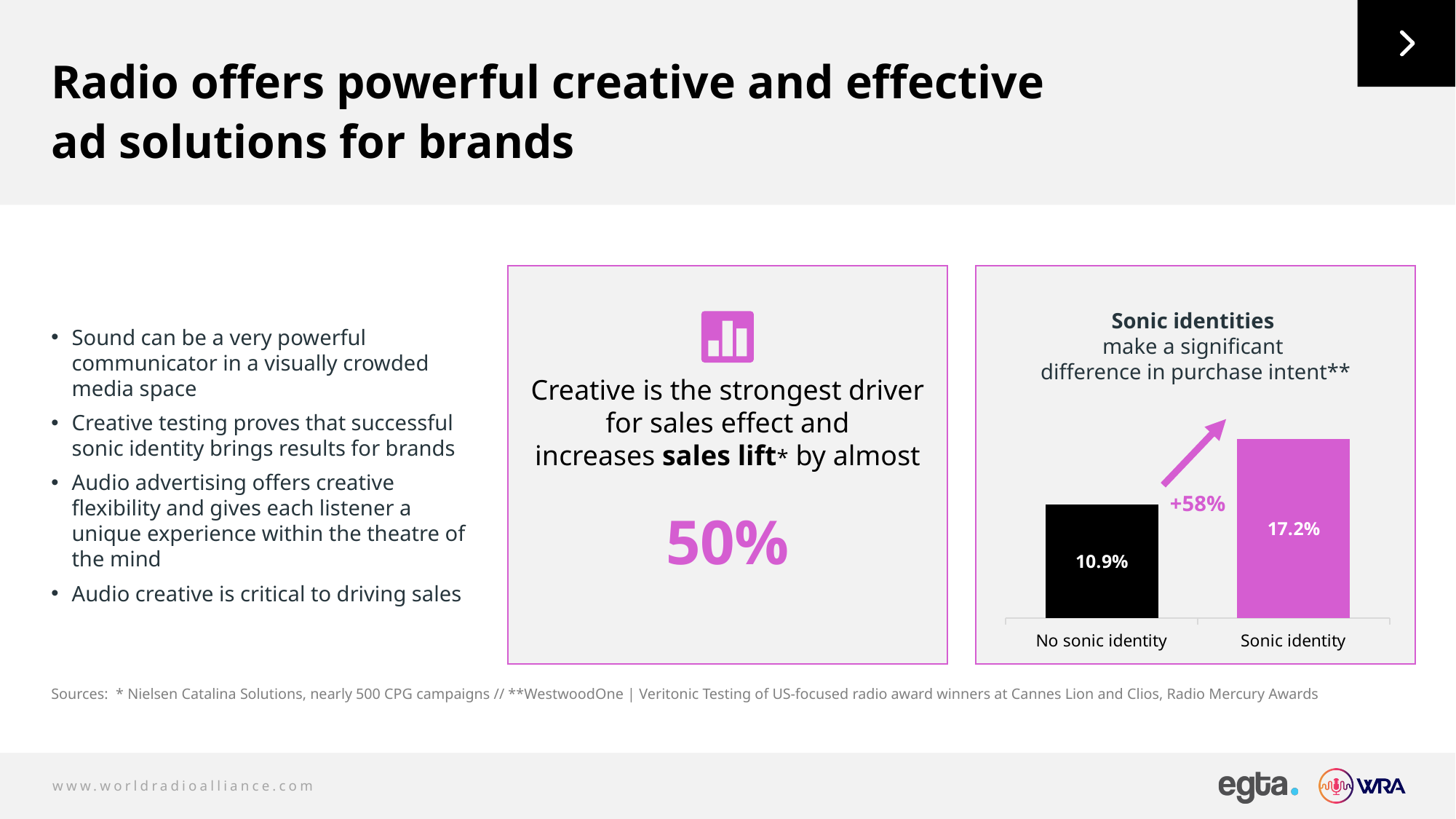
Which category has the higher value in the purchase intent chart? Sonic identity Is the value for Sonic identity larger or smaller than the value for No sonic identity? larger What kind of chart is used to show purchase intent by sonic identity? bar chart What colour is the Sonic identity bar in the purchase intent chart? pink/magenta How many categories are shown in the purchase intent chart? 2 What is the value for No sonic identity in the purchase intent chart? 10.9% What is the value for Sonic identity in the purchase intent chart? 17.2% Which category has the lower value in the purchase intent chart? No sonic identity What is the difference between the Sonic identity and No sonic identity values in the purchase intent chart? 6.3% Do the values rise or fall from No sonic identity to Sonic identity? rise What percentage increase is annotated between the two bars in the purchase intent chart? +58%